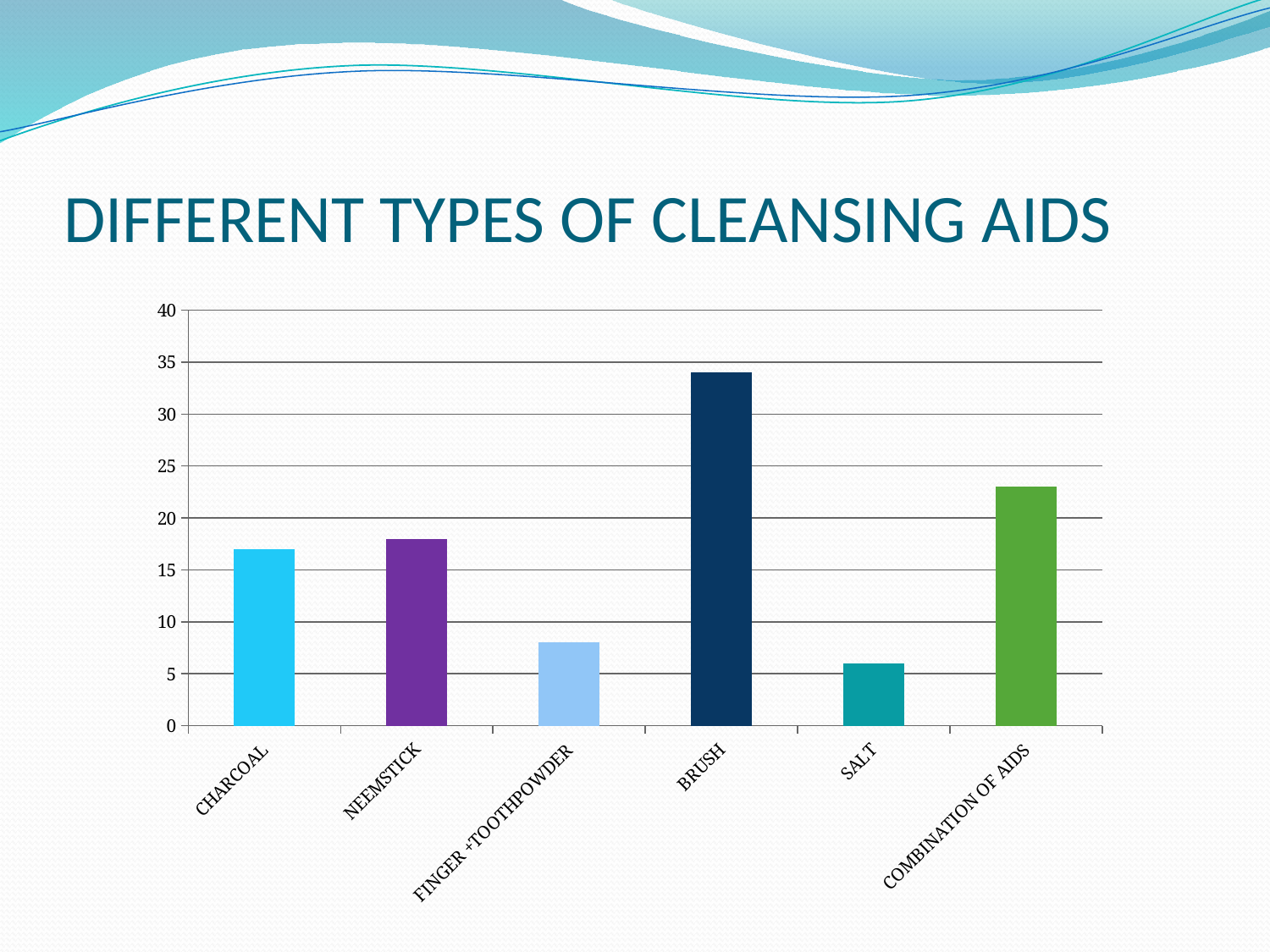
What type of chart is shown on the slide? bar chart What is the title of the slide containing the chart? DIFFERENT TYPES OF CLEANSING AIDS Is the value for SALT greater or less than 10? less Is the value for NEEMSTICK greater or less than 20? less Is the value for COMBINATION OF AIDS greater or less than 20? greater Which cleansing aid has the highest value in the chart? BRUSH Which has a larger value, BRUSH or COMBINATION OF AIDS? BRUSH Which has a larger value, CHARCOAL or FINGER +TOOTHPOWDER? CHARCOAL Which cleansing aid has the lowest value in the chart? SALT How many categories are shown on the x axis of the chart? 6